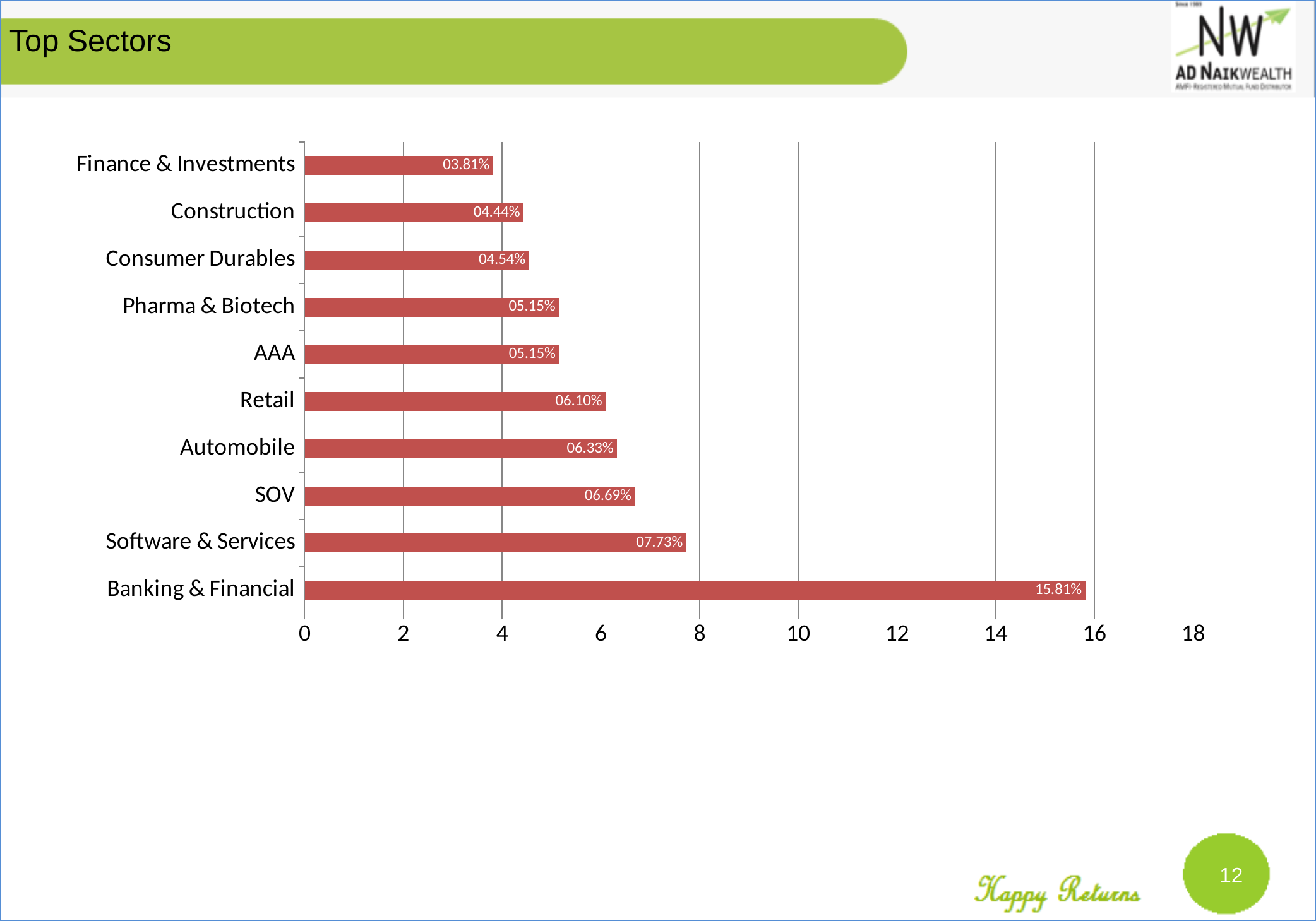
What is the difference between the values for Banking & Financial and Software & Services? 8.08% Is the value for Construction greater or less than 6? less What is the value for Banking & Financial? 15.81% What is the value for Retail? 06.10% What is the title of the slide containing the chart? Top Sectors What is the value for Finance & Investments? 03.81% Which is larger, the value for SOV or the value for Automobile? SOV How many sectors are shown in the chart? 10 Which sector has the lowest value? Finance & Investments What is the value for Software & Services? 07.73% Which sector has the highest value? Banking & Financial What kind of chart is shown on the slide? bar chart